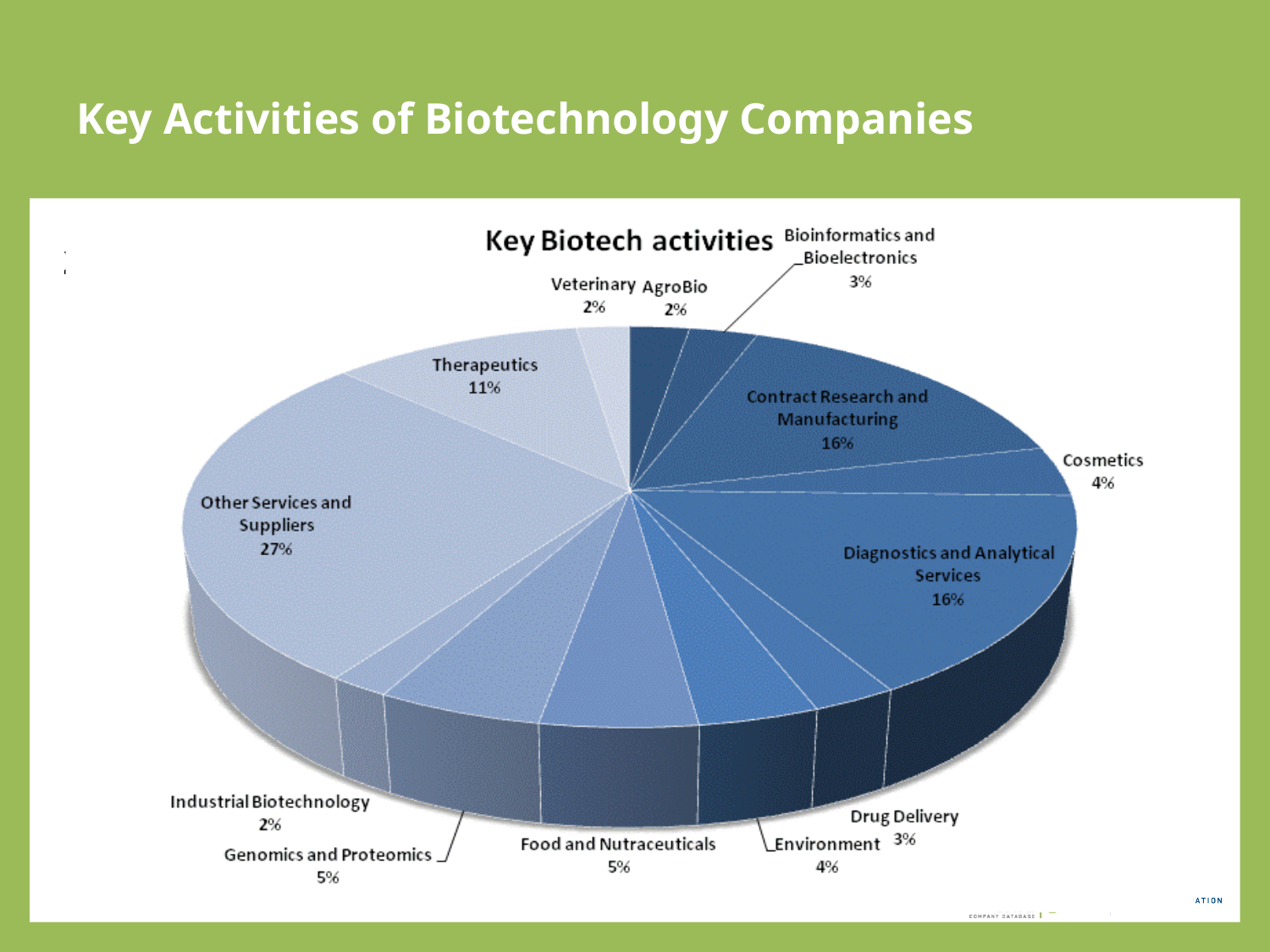
What share of the pie is Other Services and Suppliers? 27% Which category has the largest share of the pie? Other Services and Suppliers What percentage is shown for Cosmetics? 4% Which is larger, Therapeutics or Cosmetics? Therapeutics What kind of chart is shown on the slide? pie chart What is the difference between the shares of Other Services and Suppliers and Therapeutics? 16% What is the title of the chart? Key Biotech activities What percentage is shown for Food and Nutraceuticals? 5% What percentage is shown for Therapeutics? 11% What percentage is shown for Contract Research and Manufacturing? 16% What percentage is shown for Drug Delivery? 3% How many categories are shown in the pie chart? 13